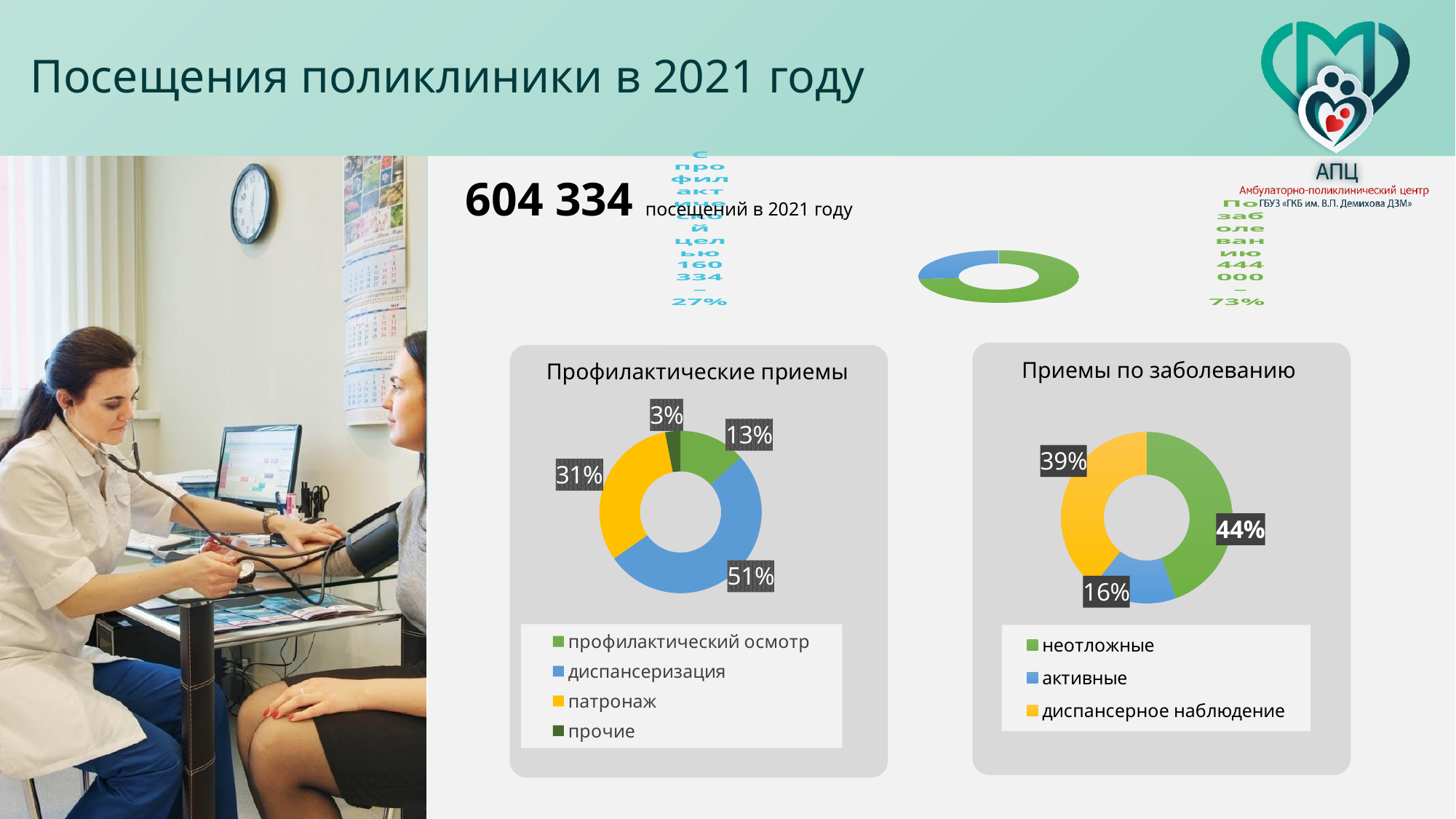
What type of chart is 'Приемы по заболеванию'? Donut (pie) chart In the 'Приемы по заболеванию' chart, which is larger: 'диспансерное наблюдение' or 'активные'? диспансерное наблюдение In the 'Приемы по заболеванию' chart, what share is 'активные'? 16% In the 'Профилактические приемы' chart, which category has the smallest share? прочие In the small chart at the top of the slide, what share of visits is 'По заболеванию'? 73% In the 'Профилактические приемы' chart, what share is 'патронаж'? 31% In the 'Приемы по заболеванию' chart, what share is 'неотложные'? 44% In the 'Профилактические приемы' chart, what is the difference in percentage points between 'диспансеризация' and 'профилактический осмотр'? 38 In the 'Приемы по заболеванию' chart, which category has the largest share? неотложные In the 'Профилактические приемы' chart, which category has the largest share? диспансеризация In the 'Профилактические приемы' chart, how many categories does the legend list? 4 In the 'Профилактические приемы' chart, what share is 'диспансеризация'? 51%